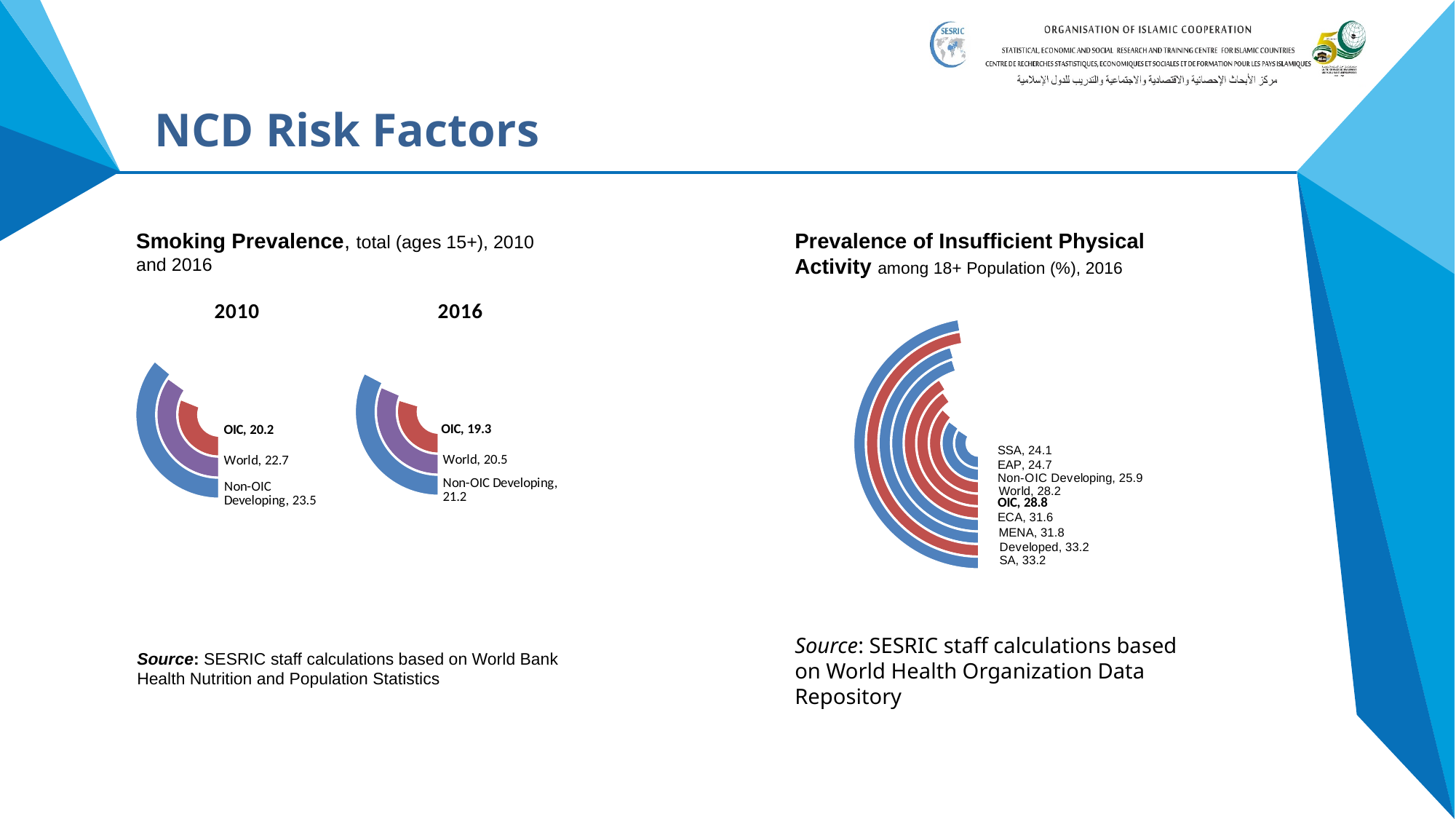
In the Smoking Prevalence chart, by how much did the OIC value fall from 2010 to 2016? 0.9 In the Prevalence of Insufficient Physical Activity chart, what is the value for OIC? 28.8 In the Prevalence of Insufficient Physical Activity chart, how many categories are shown? 9 In the Prevalence of Insufficient Physical Activity chart, which category has the lowest value? SSA In the Prevalence of Insufficient Physical Activity chart, what is the value for MENA? 31.8 In the Smoking Prevalence chart, which category has the highest value in 2010? Non-OIC Developing In the Prevalence of Insufficient Physical Activity chart, what is the difference between the Developed and World values? 5.0 In the Smoking Prevalence chart, how many categories are shown for each year? 3 In the Smoking Prevalence chart, what is the value for OIC in 2010? 20.2 In the Smoking Prevalence chart, what is the value for World in 2016? 20.5 In the Smoking Prevalence chart, which category has the lowest value in 2016? OIC In the Smoking Prevalence chart, what is the value for Non-OIC Developing in 2016? 21.2